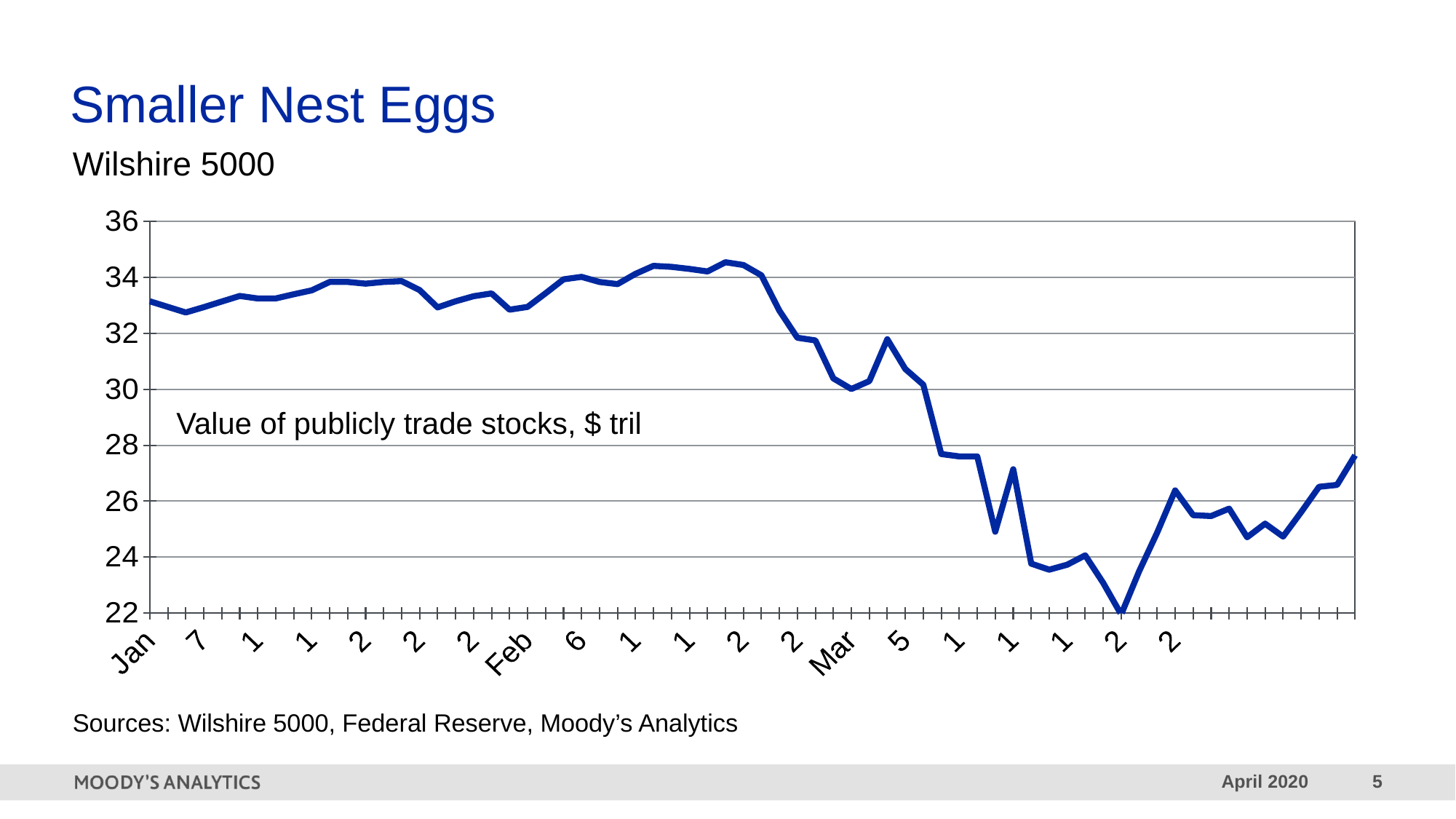
Is the last value on the line greater or less than 26? greater What is the highest value shown on the vertical axis? 36 Is the lowest value on the line greater or less than 24? less Overall, does the value rise or fall from the start of January to the end of the series? fall Does the value rise or fall between the Feb tick and the Mar tick? fall Is the value at the Feb tick greater or less than 32? greater What kind of chart is shown on the slide? line chart What does the annotation inside the chart say the line measures? Value of publicly trade stocks, $ tril How many lines are plotted on the chart? 1 What is the subtitle of the chart on the slide? Wilshire 5000